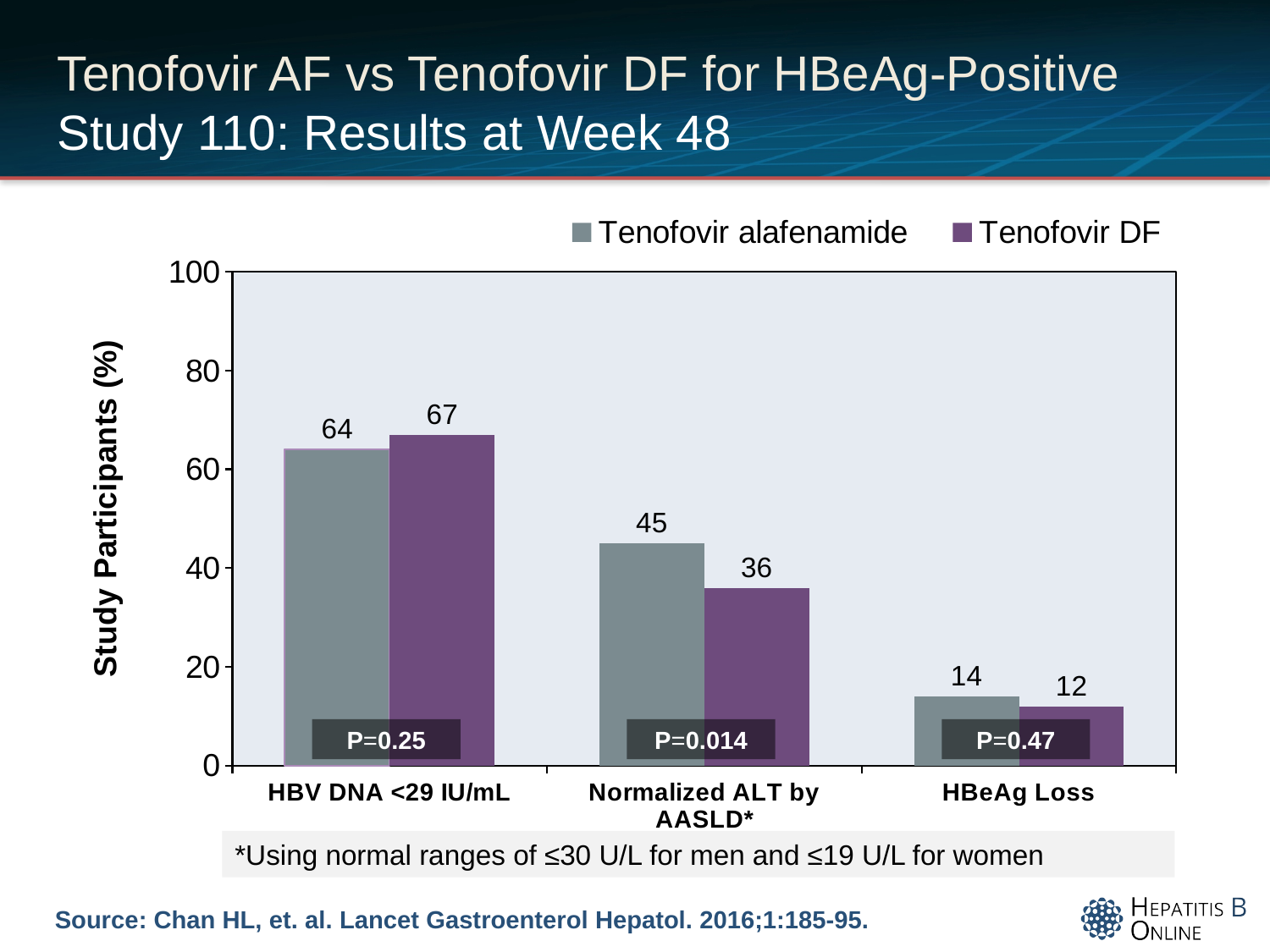
How many series does the legend list? 2 What is the value for Tenofovir DF in the HBeAg Loss category? 12 What is the value for Tenofovir alafenamide in the HBV DNA <29 IU/mL category? 64 Which category has the highest value for Tenofovir DF? HBV DNA <29 IU/mL What kind of chart is shown on the slide? bar chart What is the value for Tenofovir DF in the Normalized ALT by AASLD* category? 36 What is the difference between the Tenofovir alafenamide and Tenofovir DF values in the Normalized ALT by AASLD* category? 9 How many categories are shown on the x axis? 3 Which category has the lowest value for Tenofovir alafenamide? HBeAg Loss What is the y-axis label of the chart? Study Participants (%) Is the value for Tenofovir alafenamide in the HBeAg Loss category greater or less than 20? less In the HBV DNA <29 IU/mL category, which series has the larger value? Tenofovir DF